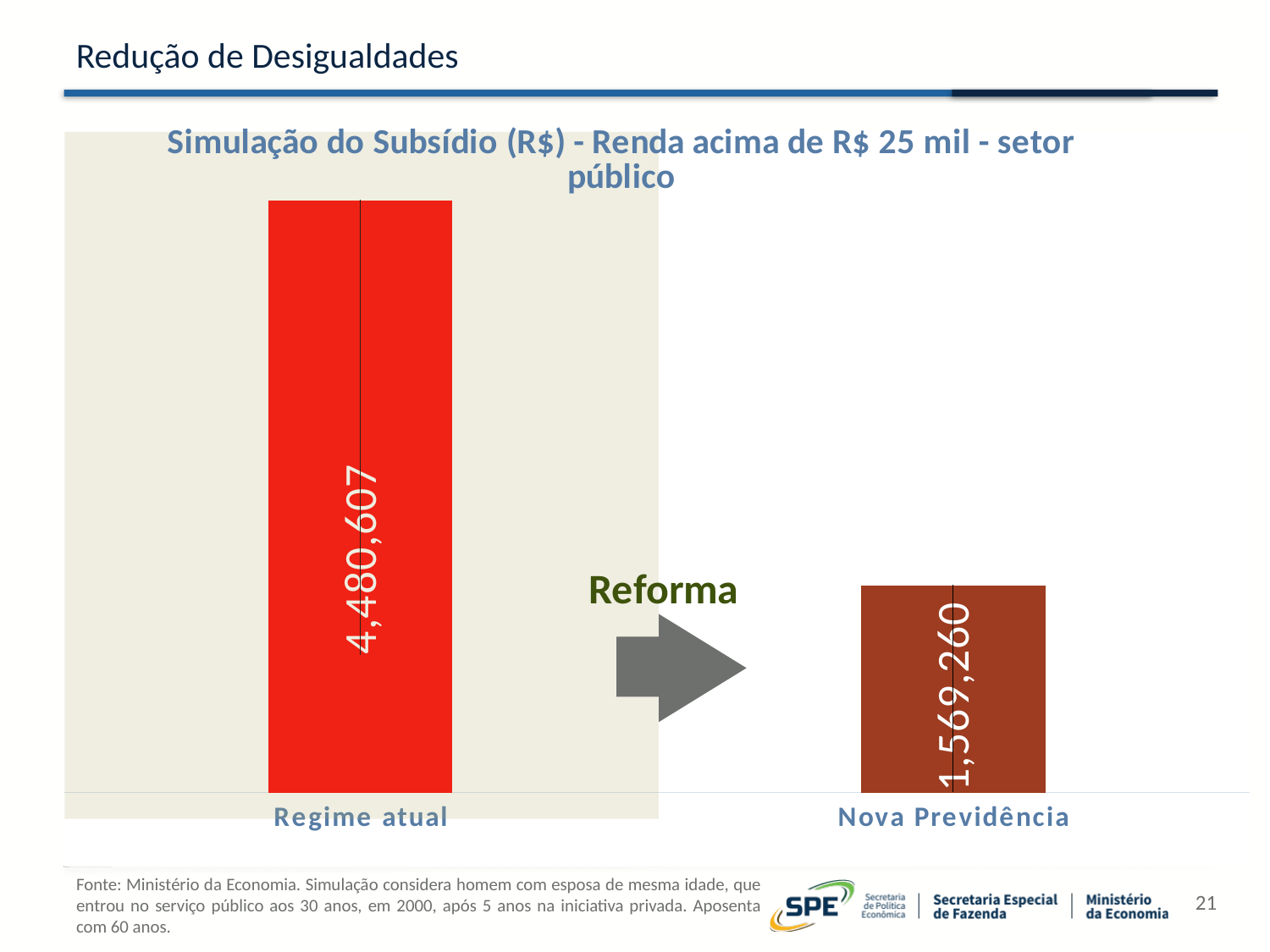
Do the values rise or fall from Regime atual to Nova Previdência? Fall What is the value for Regime atual? 4,480,607 What kind of chart is shown on the slide? Bar chart Which category has the lowest value? Nova Previdência How many categories are shown in the chart? 2 Which category has the highest value? Regime atual Which is larger, the value for Regime atual or the value for Nova Previdência? Regime atual What is the title of the chart? Simulação do Subsídio (R$) - Renda acima de R$ 25 mil - setor público What is the value for Nova Previdência? 1,569,260 What is the difference between the values for Regime atual and Nova Previdência? 2,911,347 What word is written above the arrow between the two bars? Reforma